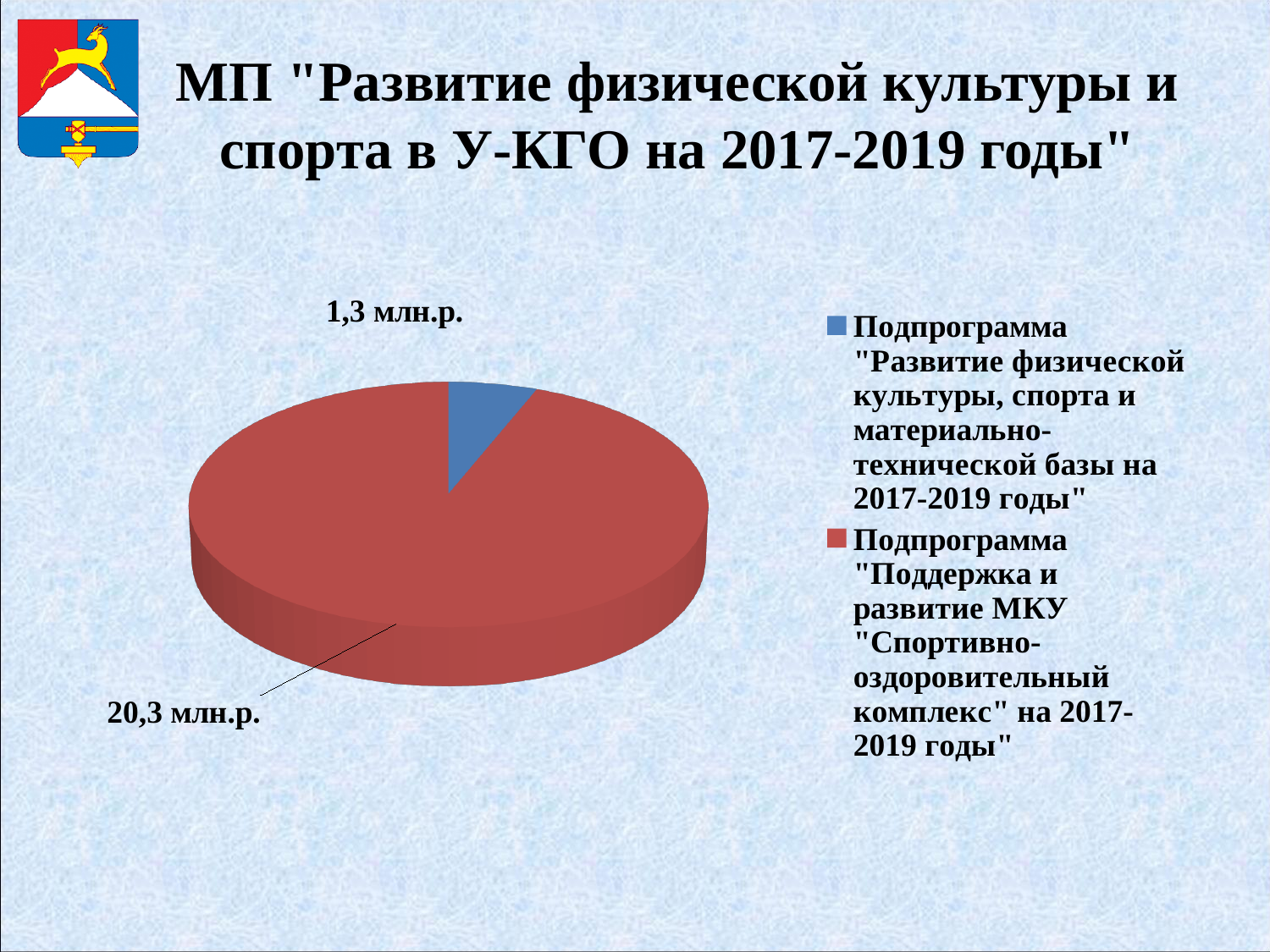
What kind of chart is shown on the slide? Pie chart Which subprogram has the largest slice of the pie? Подпрограмма "Поддержка и развитие МКУ "Спортивно-оздоровительный комплекс" на 2017-2019 годы" What is the value for Подпрограмма "Развитие физической культуры, спорта и материально-технической базы на 2017-2019 годы"? 1,3 млн.р. What colour is the slice for Подпрограмма "Развитие физической культуры, спорта и материально-технической базы на 2017-2019 годы"? Blue Which subprogram has the smallest slice of the pie? Подпрограмма "Развитие физической культуры, спорта и материально-технической базы на 2017-2019 годы" Which is larger: the value for the blue slice or the value for the red slice? The red slice (20,3 млн.р.) What is the title of the slide containing the pie chart? МП "Развитие физической культуры и спорта в У-КГО на 2017-2019 годы" How many entries does the legend of the pie chart list? 2 How many slices does the pie chart have? 2 What is the difference between the two values shown on the pie chart? 19,0 млн.р. What is the value for Подпрограмма "Поддержка и развитие МКУ "Спортивно-оздоровительный комплекс" на 2017-2019 годы"? 20,3 млн.р. What is the total of the two values shown on the pie chart? 21,6 млн.р.